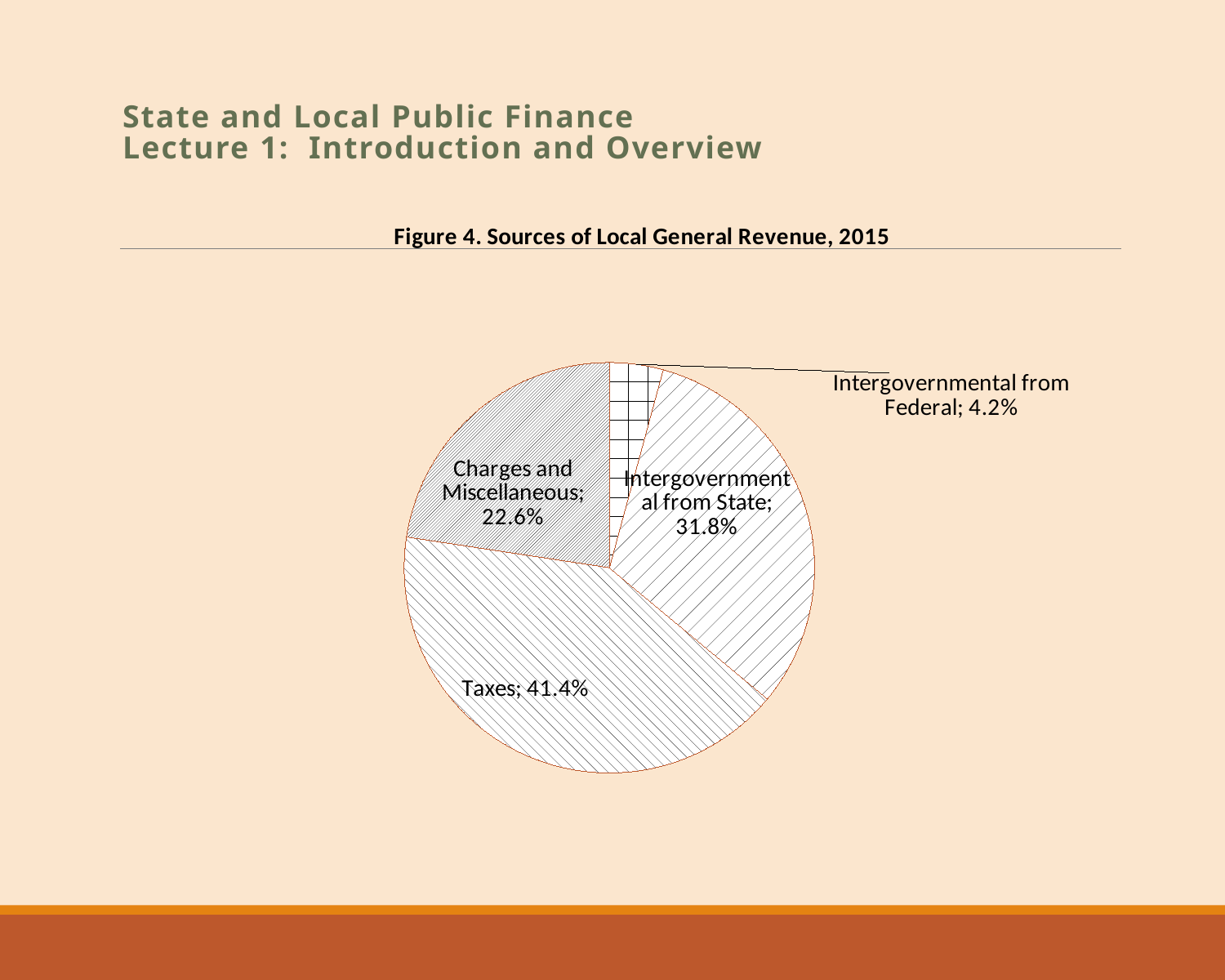
What is the combined share of Intergovernmental from State and Intergovernmental from Federal? 36.0% What share of local general revenue comes from Taxes? 41.4% What share of local general revenue comes from Intergovernmental from Federal? 4.2% Which source accounts for the smallest share of local general revenue? Intergovernmental from Federal What kind of chart is shown on the slide? Pie chart How many slices does the pie chart have? 4 Which is larger: the share from Intergovernmental from State or the share from Charges and Miscellaneous? Intergovernmental from State What is the title of the chart? Figure 4. Sources of Local General Revenue, 2015 What share of local general revenue comes from Intergovernmental from State? 31.8% What is the difference in percentage points between the Taxes share and the Intergovernmental from State share? 9.6 percentage points Which source accounts for the largest share of local general revenue? Taxes What share of local general revenue comes from Charges and Miscellaneous? 22.6%